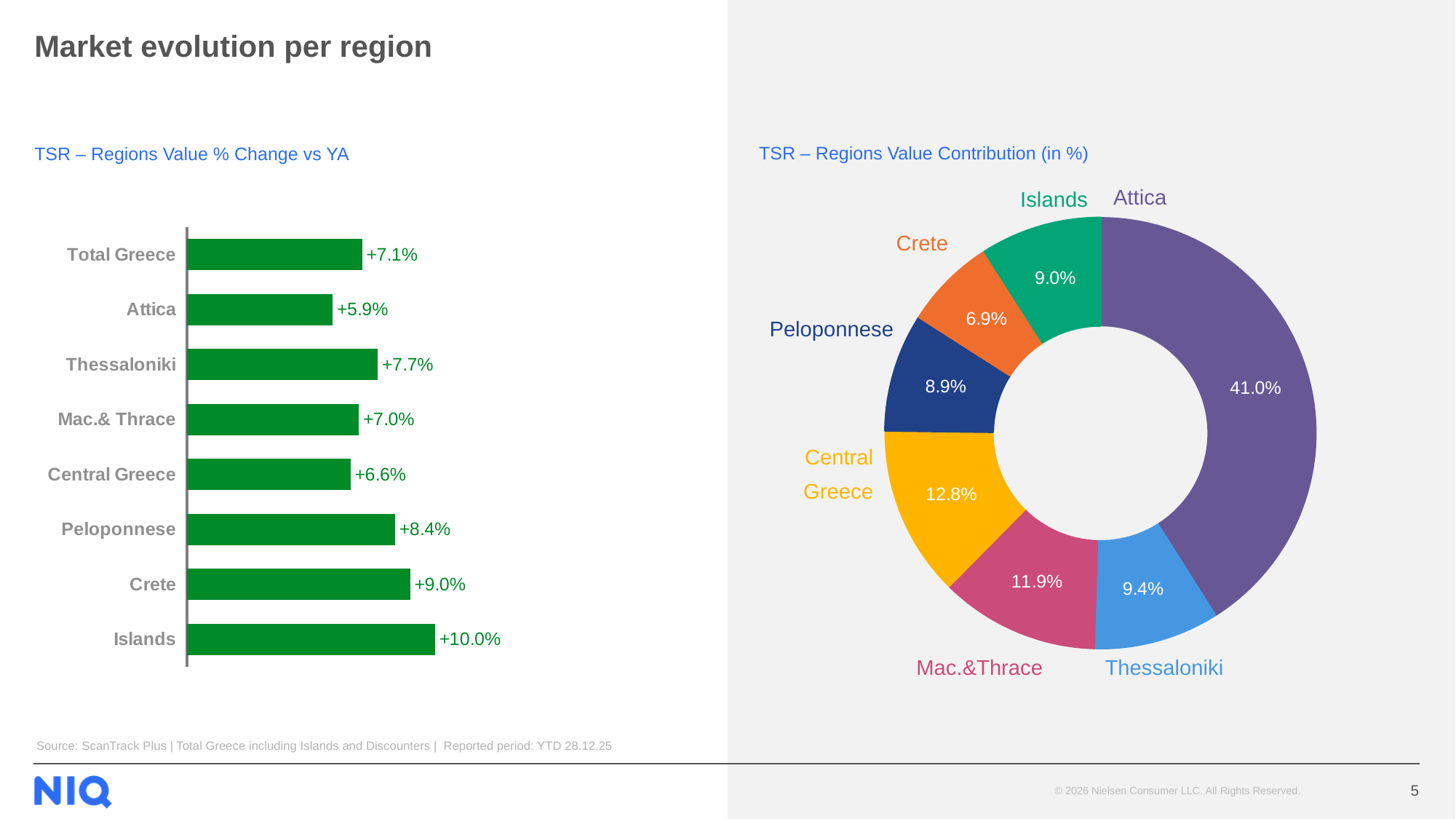
In the 'TSR – Regions Value Contribution (in %)' chart, which region has the smallest share? Crete In the 'TSR – Regions Value Contribution (in %)' chart, what is the difference between the shares of Mac.&Thrace and Thessaloniki? 2.5 percentage points How many bars are shown in the 'TSR – Regions Value % Change vs YA' chart? 8 In the 'TSR – Regions Value % Change vs YA' chart, what is the value for Total Greece? +7.1% In the 'TSR – Regions Value % Change vs YA' chart, which is larger, the value for Peloponnese or the value for Mac.& Thrace? Peloponnese In the 'TSR – Regions Value % Change vs YA' chart, what is the value for Thessaloniki? +7.7% In the 'TSR – Regions Value Contribution (in %)' chart, which region has the largest share? Attica What kind of chart is the 'TSR – Regions Value % Change vs YA' chart? Bar chart In the 'TSR – Regions Value Contribution (in %)' chart, what is the share for Central Greece? 12.8% In the 'TSR – Regions Value % Change vs YA' chart, which region has the lowest value change? Attica In the 'TSR – Regions Value % Change vs YA' chart, which region has the highest value change? Islands In the 'TSR – Regions Value % Change vs YA' chart, what is the difference between the values for Crete and Central Greece? 2.4 percentage points